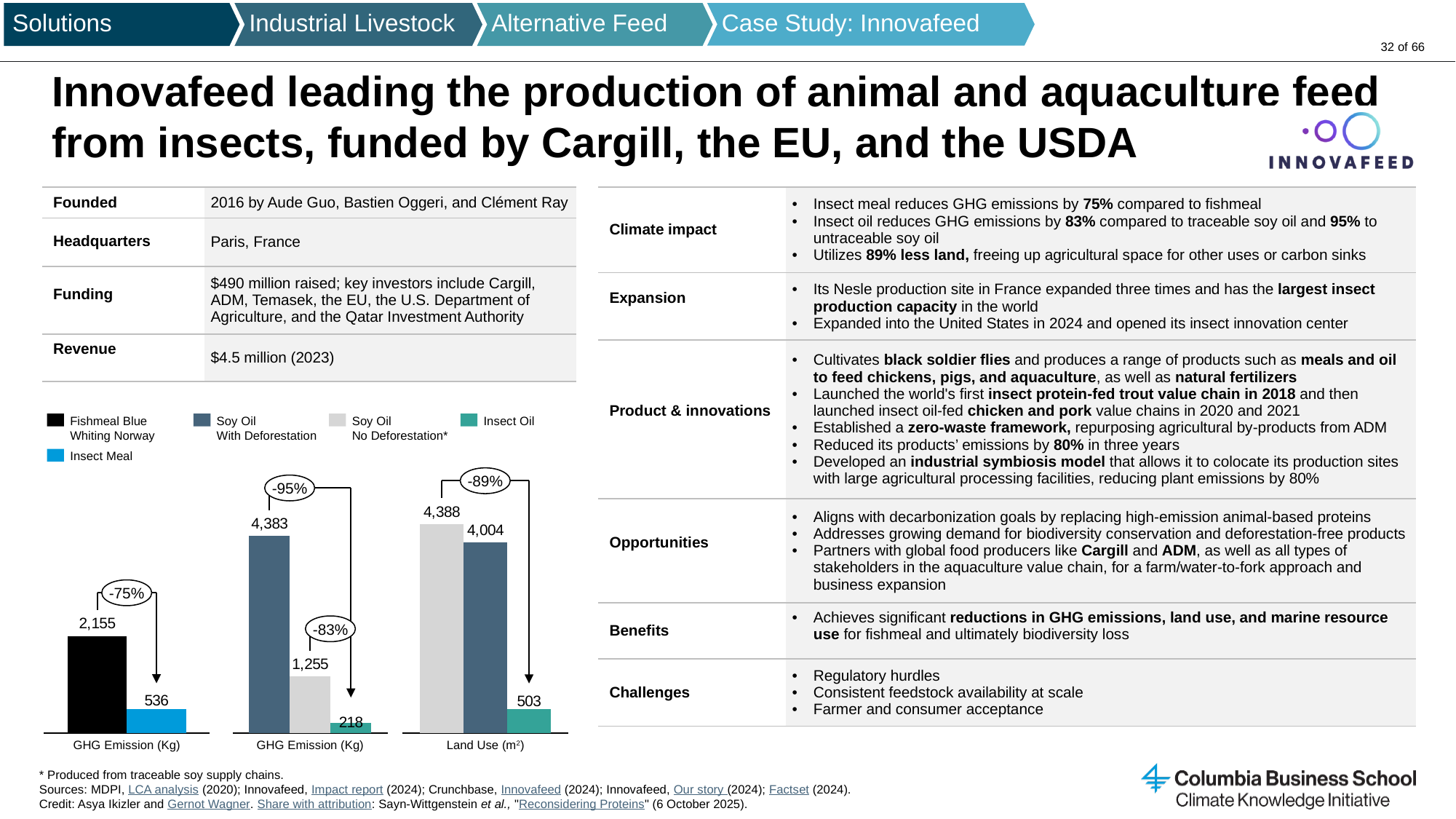
In the middle chart (GHG Emission (Kg)), which category has the lowest value? Insect Oil In the left chart (GHG Emission (Kg)), what is the value for Insect Meal? 536 How many series does the shared legend for the charts list? 5 In the right chart (Land Use (m²)), what is the value for Insect Oil? 503 In the middle chart (GHG Emission (Kg)), what is the value for Insect Oil? 218 What kind of chart is the right chart (Land Use (m²))? Bar chart In the left chart (GHG Emission (Kg)), what is the value for Fishmeal Blue Whiting Norway? 2,155 In the right chart (Land Use (m²)), which category has the highest value? Soy Oil No Deforestation In the middle chart (GHG Emission (Kg)), which is larger: Soy Oil No Deforestation or Insect Oil? Soy Oil No Deforestation In the middle chart (GHG Emission (Kg)), what is the value for Soy Oil With Deforestation? 4,383 In the left chart (GHG Emission (Kg)), what is the difference between Fishmeal Blue Whiting Norway and Insect Meal? 1,619 In the right chart (Land Use (m²)), what is the value for Soy Oil No Deforestation? 4,388